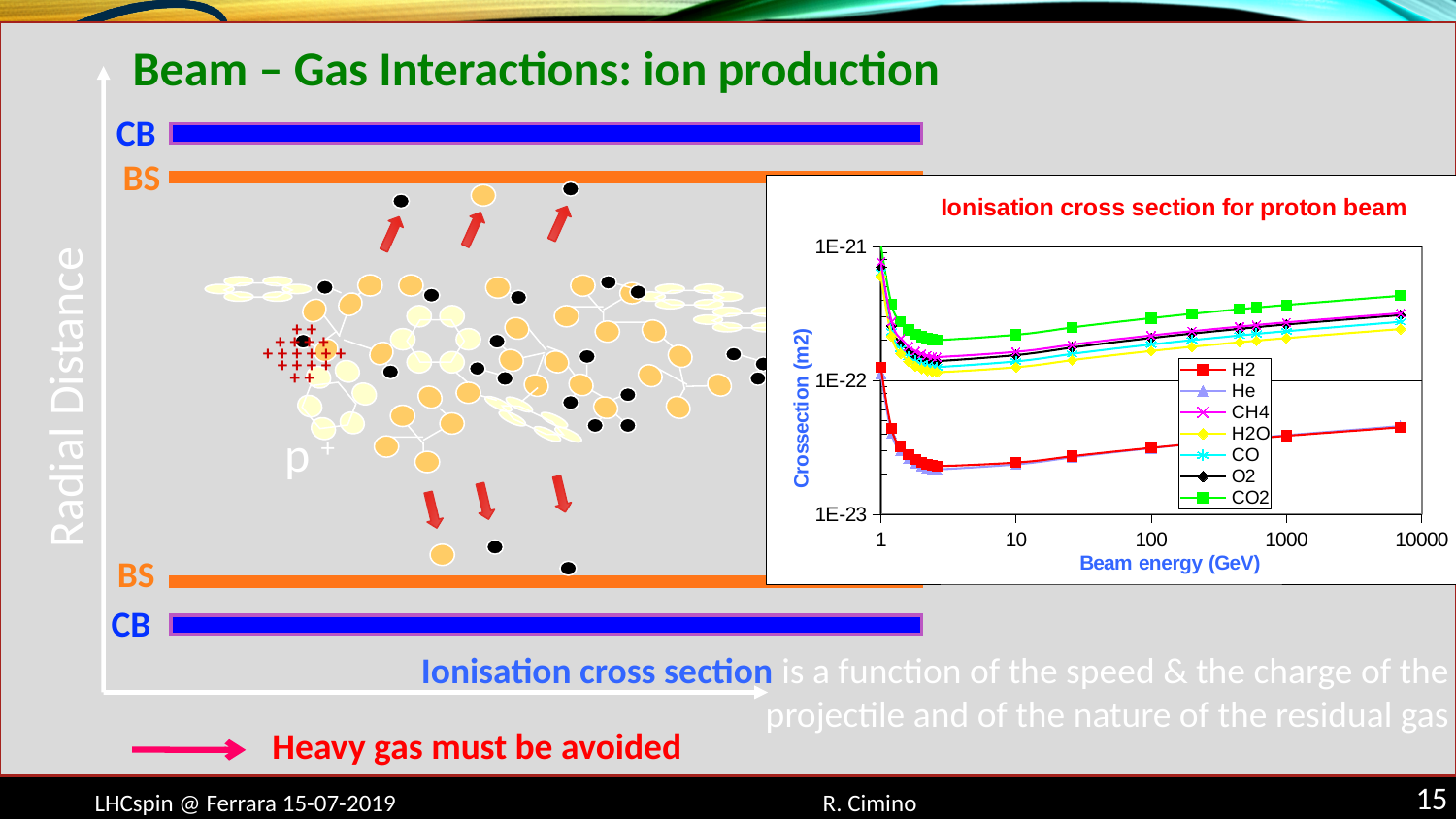
In the 'Ionisation cross section for proton beam' chart, does the H2 curve rise or fall between 1 GeV and 3 GeV? fall In the 'Ionisation cross section for proton beam' chart, is the cross section for H2 at 10 GeV greater or less than 1E-22? less How many series does the legend of the 'Ionisation cross section for proton beam' chart list? 7 In the 'Ionisation cross section for proton beam' chart, which is larger at 100 GeV: the cross section for CO2 or for H2? CO2 What is the y-axis label of the 'Ionisation cross section for proton beam' chart? Crossection (m2) Which gas has the highest ionisation cross section at 1000 GeV in the 'Ionisation cross section for proton beam' chart? CO2 What kind of chart is the 'Ionisation cross section for proton beam' chart? line chart In the 'Ionisation cross section for proton beam' chart, does the CO2 curve rise or fall between 10 GeV and 10000 GeV? rise What is the x-axis label of the 'Ionisation cross section for proton beam' chart? Beam energy (GeV)